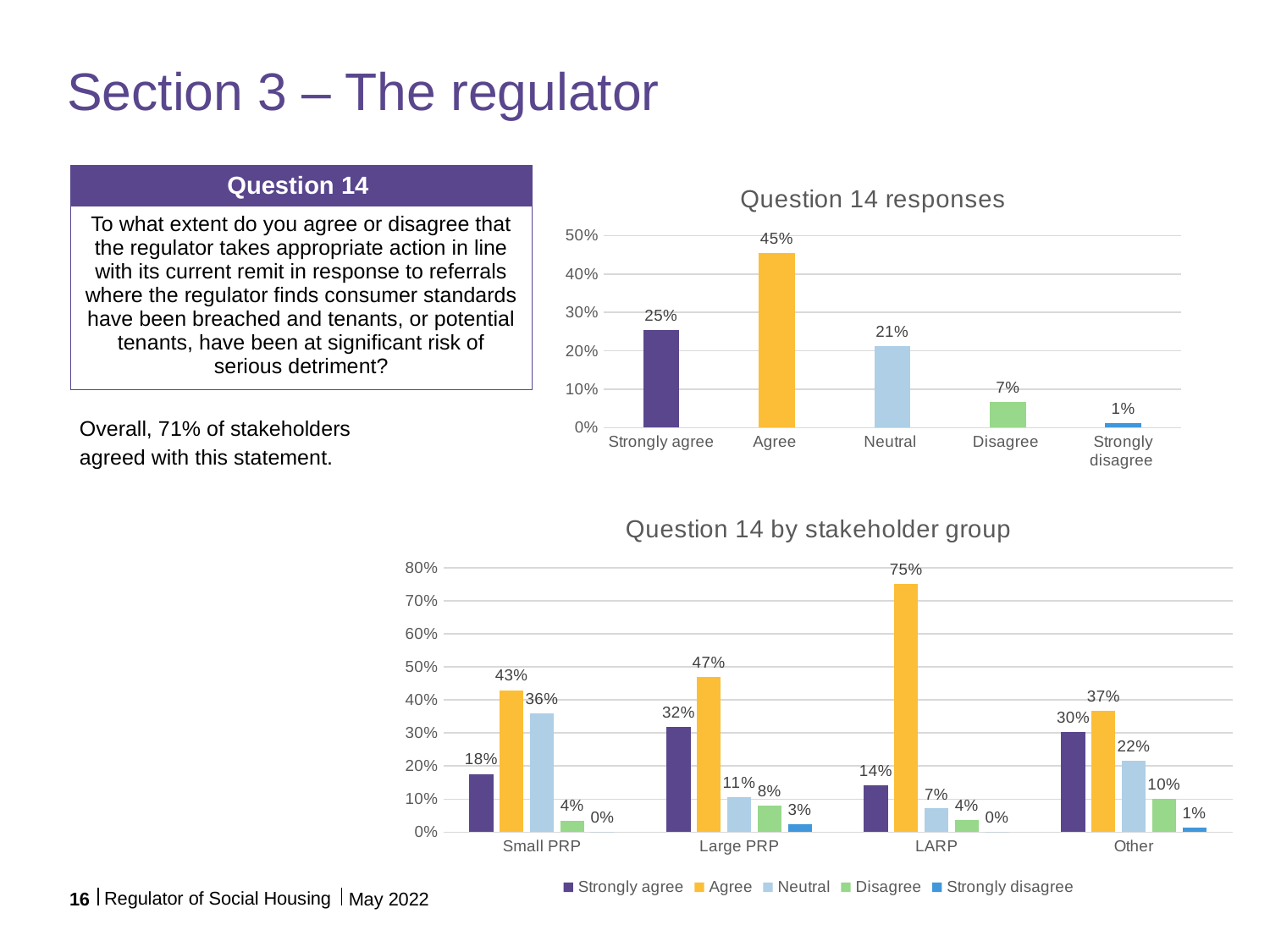
In the 'Question 14 responses' chart, how many response categories are shown on the x axis? 5 In the 'Question 14 by stakeholder group' chart, which colour represents the Agree series? Yellow In the 'Question 14 by stakeholder group' chart, which stakeholder group has the highest Neutral value? Small PRP In the 'Question 14 by stakeholder group' chart, is the Strongly agree value for Large PRP larger or smaller than the Strongly agree value for Other? Larger In the 'Question 14 by stakeholder group' chart, how many stakeholder groups are shown on the x axis? 4 In the 'Question 14 responses' chart, what percentage of respondents chose Agree? 45% What type of chart is the 'Question 14 responses' chart? Bar chart In the 'Question 14 responses' chart, which response category has the lowest value? Strongly disagree In the 'Question 14 by stakeholder group' chart, what percentage of LARP respondents chose Agree? 75% In the 'Question 14 responses' chart, what is the difference between the Strongly agree and Neutral values? 4% How many series does the legend of the 'Question 14 by stakeholder group' chart list? 5 In the 'Question 14 by stakeholder group' chart, what is the difference between the Agree values for Large PRP and Small PRP? 4%